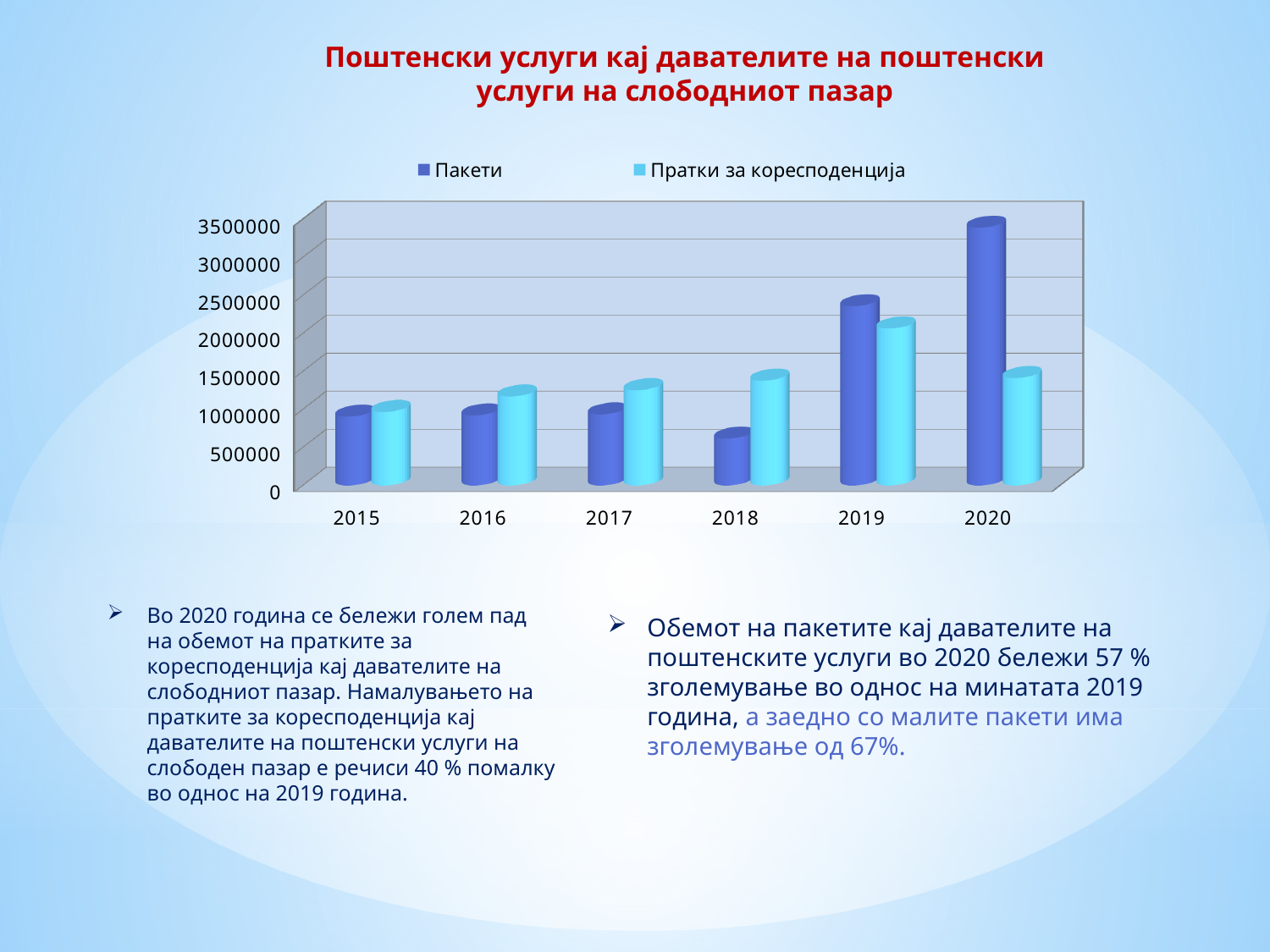
In 2018, which series has the larger value, Пакети or Пратки за кореспонденција? Пратки за кореспонденција In which year is the value for Пакети lowest? 2018 In which year is the value for Пратки за кореспонденција highest? 2019 In 2020, which series has the larger value, Пакети or Пратки за кореспонденција? Пакети Do the values for Пратки за кореспонденција rise or fall from 2015 to 2019? rise What kind of chart is shown on the slide? bar chart How many series does the legend list? 2 Is the value for Пакети in 2020 greater or less than 3000000? greater How many years are shown on the x axis? 6 Is the value for Пакети in 2018 greater or less than 1000000? less In which year is the value for Пакети highest? 2020